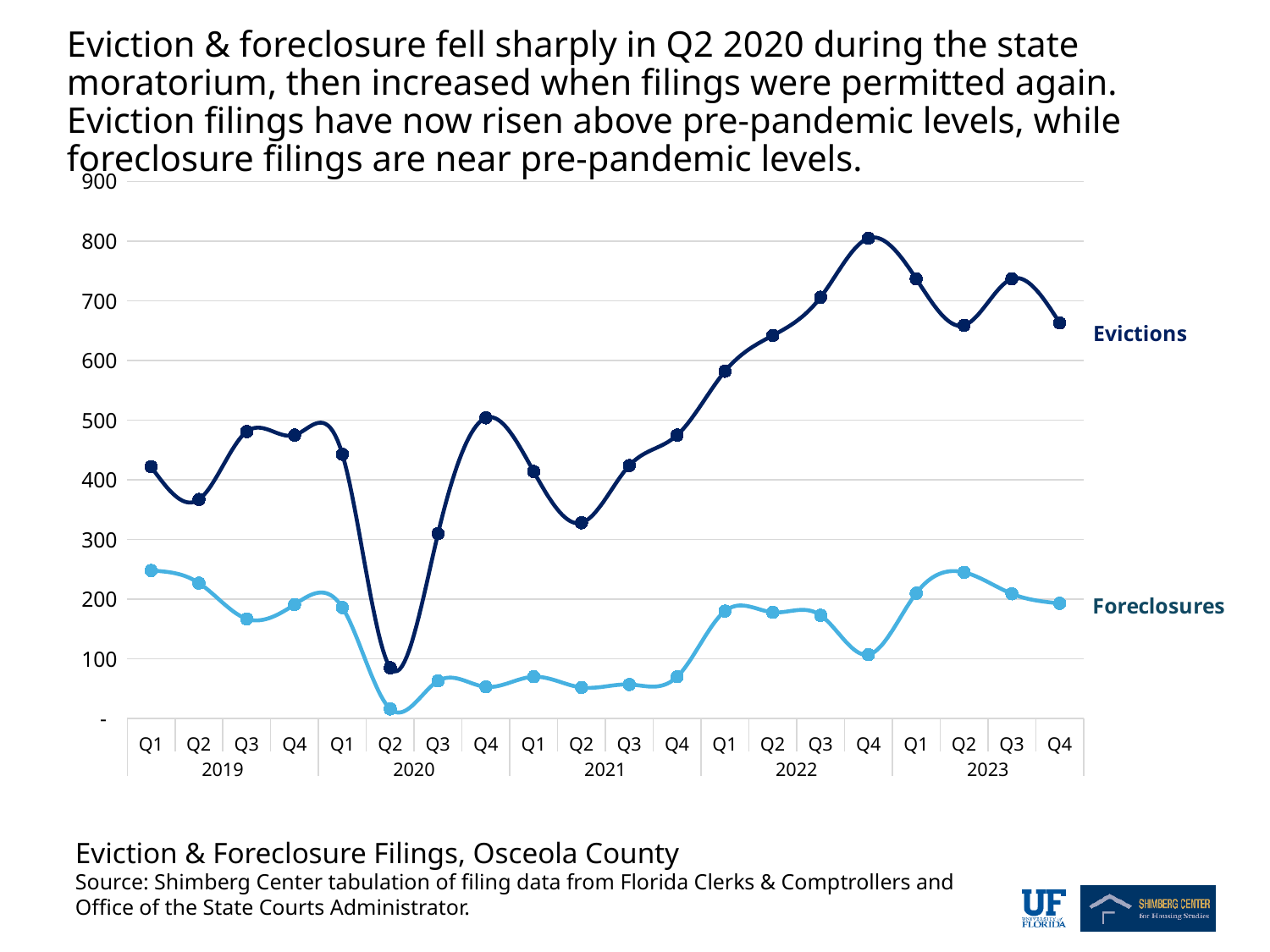
How many quarterly data points does each line have? 20 Do Evictions rise or fall from Q2 2021 to Q4 2022? Rise How many series are plotted on the chart? 2 Is the value for Evictions in Q4 2022 greater or less than 700? greater In which quarter do Evictions reach their highest value? Q4 2022 What kind of chart is shown on the slide? Line chart Which is larger: Evictions in Q4 2022 or Evictions in Q1 2019? Q4 2022 Is the value for Foreclosures in Q4 2022 greater or less than 200? less Is the value for Foreclosures in Q2 2020 greater or less than 100? less What is the title of the chart? Eviction & Foreclosure Filings, Osceola County In which quarter do Evictions reach their lowest value? Q2 2020 In which quarter do Foreclosures reach their lowest value? Q2 2020